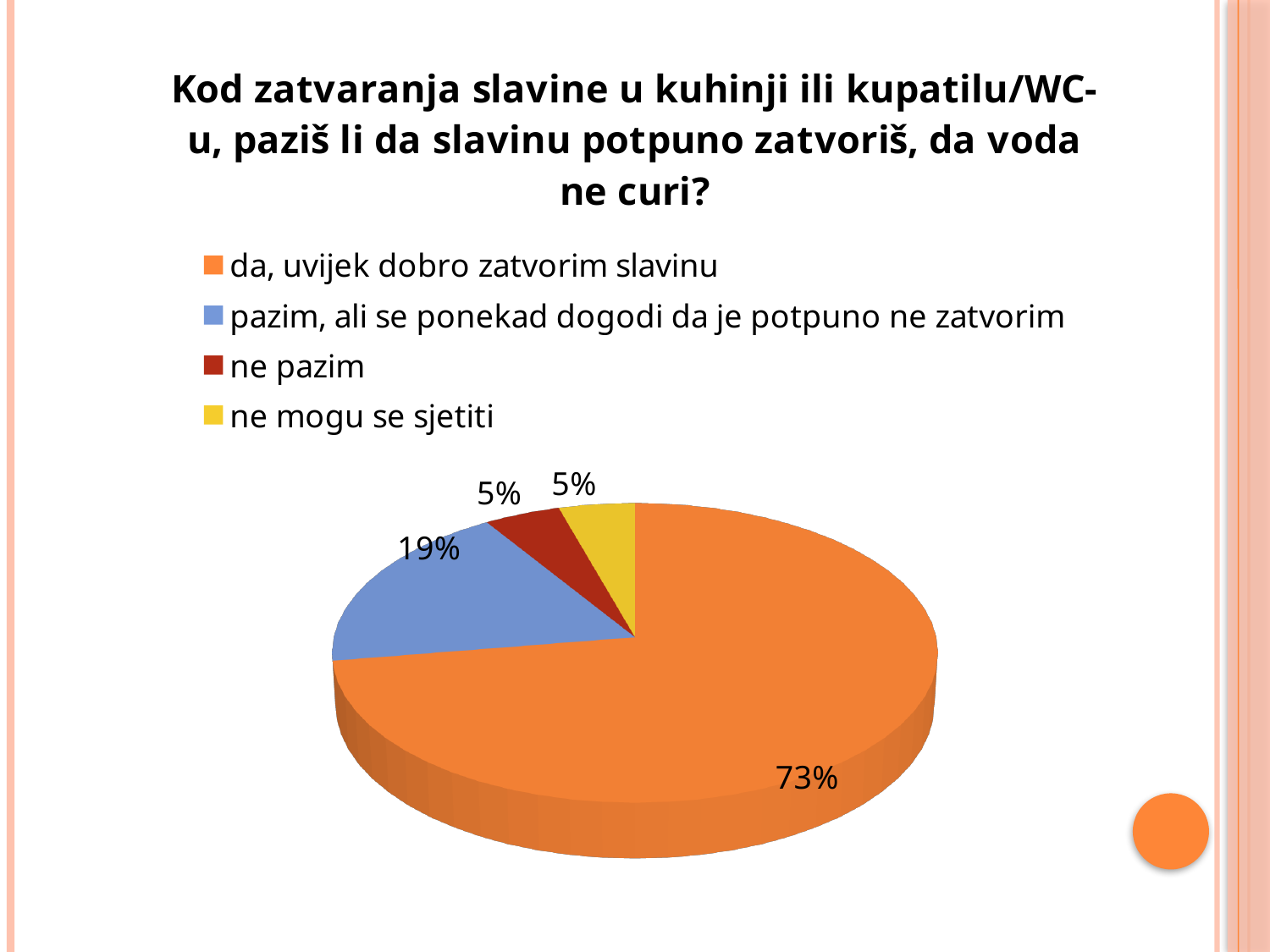
How many categories does the pie chart show? 4 What share of the pie does "da, uvijek dobro zatvorim slavinu" have? 73% What share of the pie does "ne mogu se sjetiti" have? 5% What share of the pie does "ne pazim" have? 5% What is the difference in percentage points between "da, uvijek dobro zatvorim slavinu" and "pazim, ali se ponekad dogodi da je potpuno ne zatvorim"? 54 What is the combined share of "ne pazim" and "ne mogu se sjetiti"? 10% What colour is the slice for "ne mogu se sjetiti"? yellow Which is larger: the slice for "pazim, ali se ponekad dogodi da je potpuno ne zatvorim" or the slice for "ne pazim"? pazim, ali se ponekad dogodi da je potpuno ne zatvorim Which category has the largest slice of the pie? da, uvijek dobro zatvorim slavinu What kind of chart is shown on the slide? pie chart What colour is the slice for "ne pazim"? red